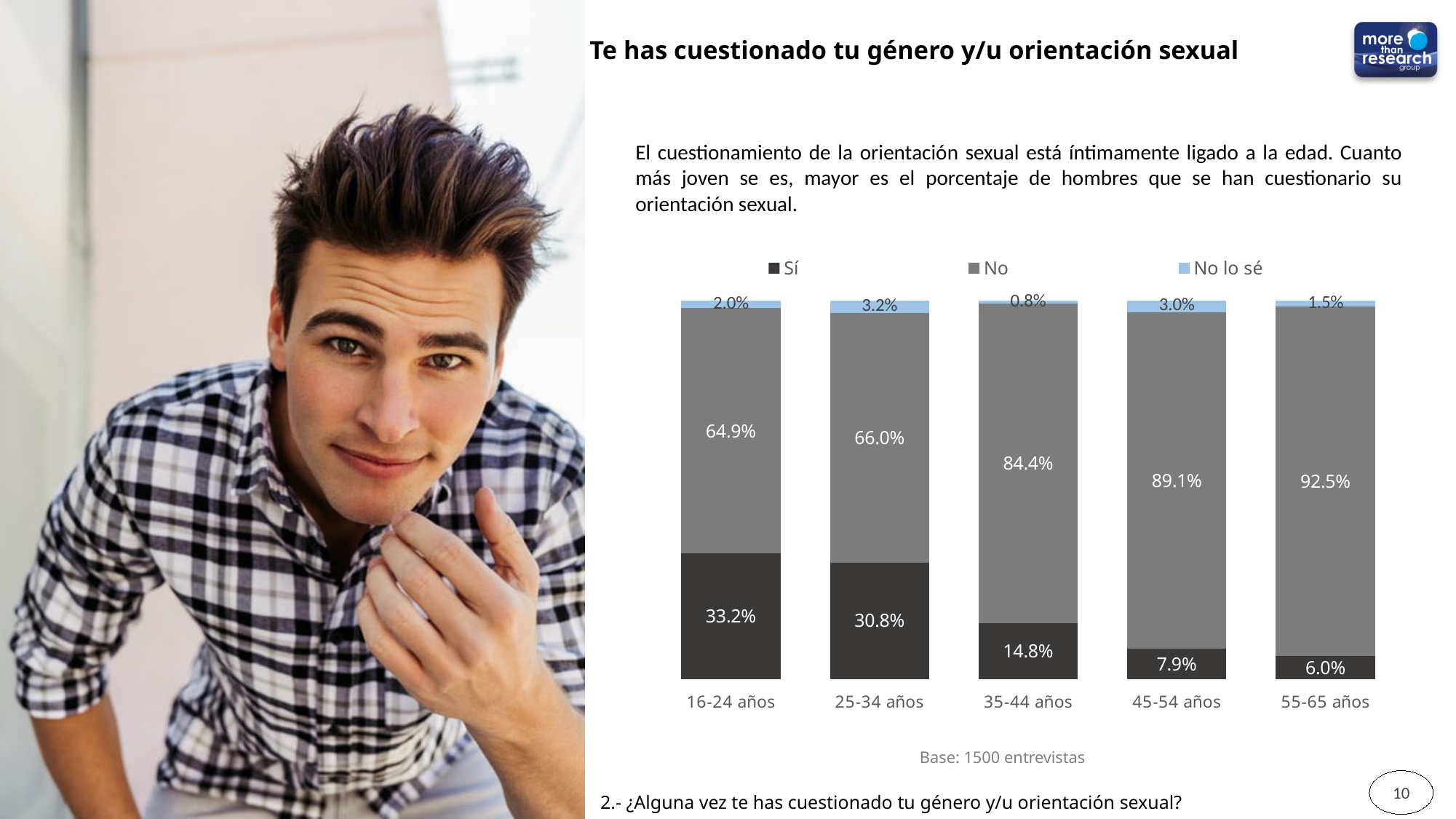
What kind of chart is shown on the slide? Stacked bar chart What is the value for "No lo sé" in the 25-34 años category? 3.2% How many age categories are shown on the x axis? 5 Which age group has the highest value for "No"? 55-65 años Which is larger: the "Sí" value for 35-44 años or for 45-54 años? 35-44 años How many series does the legend list? 3 What is the value for "Sí" in the 16-24 años category? 33.2% Do the "Sí" values rise or fall as age increases along the x axis? Fall What is the difference between the "Sí" values for 16-24 años and 55-65 años? 27.2 percentage points What is the value for "No" in the 45-54 años category? 89.1% Which age group has the lowest value for "No lo sé"? 35-44 años Which age group has the highest value for "Sí"? 16-24 años